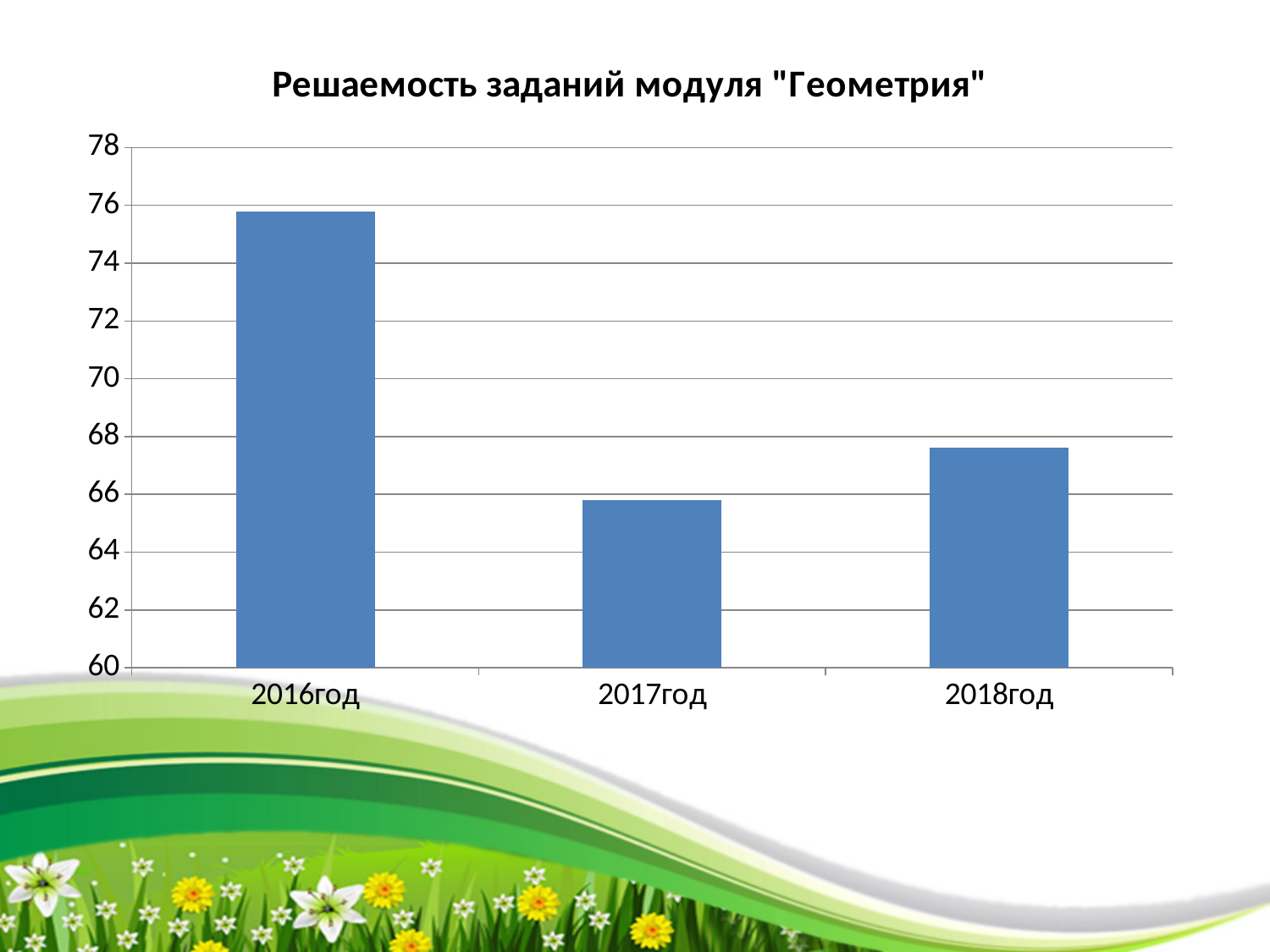
Which is larger, the value for 2016год or the value for 2018год? 2016год Is the value for 2018год greater or less than 66? greater Which is larger, the value for 2017год or the value for 2018год? 2018год Is the value for 2016год greater or less than 74? greater Does the value rise or fall from 2016год to 2017год? fall What kind of chart is shown on the slide? bar chart Which year has the highest value? 2016год Which year has the lowest value? 2017год Is the value for 2018год greater or less than 70? less What is the title of the chart? Решаемость заданий модуля "Геометрия" How many years (categories) are shown on the x axis? 3